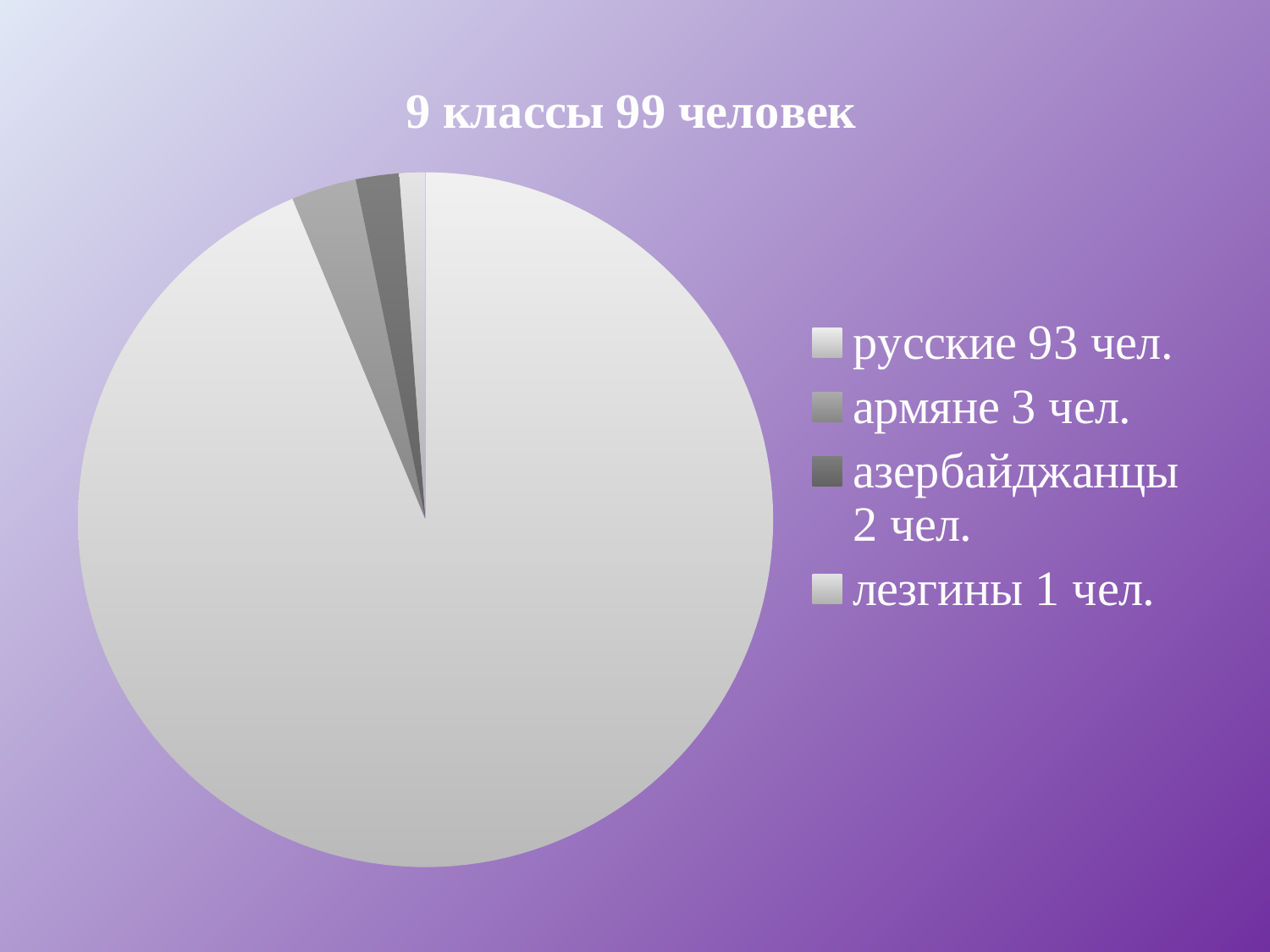
How many categories does the pie chart have? 4 What is the difference between the number of русские and the number of армяне? 90 What kind of chart is shown on the slide? pie chart Which category has the smallest slice of the pie? лезгины Which is larger, the армяне slice or the азербайджанцы slice? армяне How many people are in the азербайджанцы category? 2 чел. What is the title of the chart? 9 классы 99 человек What is the total number of people represented in the pie chart? 99 Which category has the largest slice of the pie? русские How many people are in the армяне category? 3 чел. How many people are in the лезгины category? 1 чел. How many people are in the русские category? 93 чел.